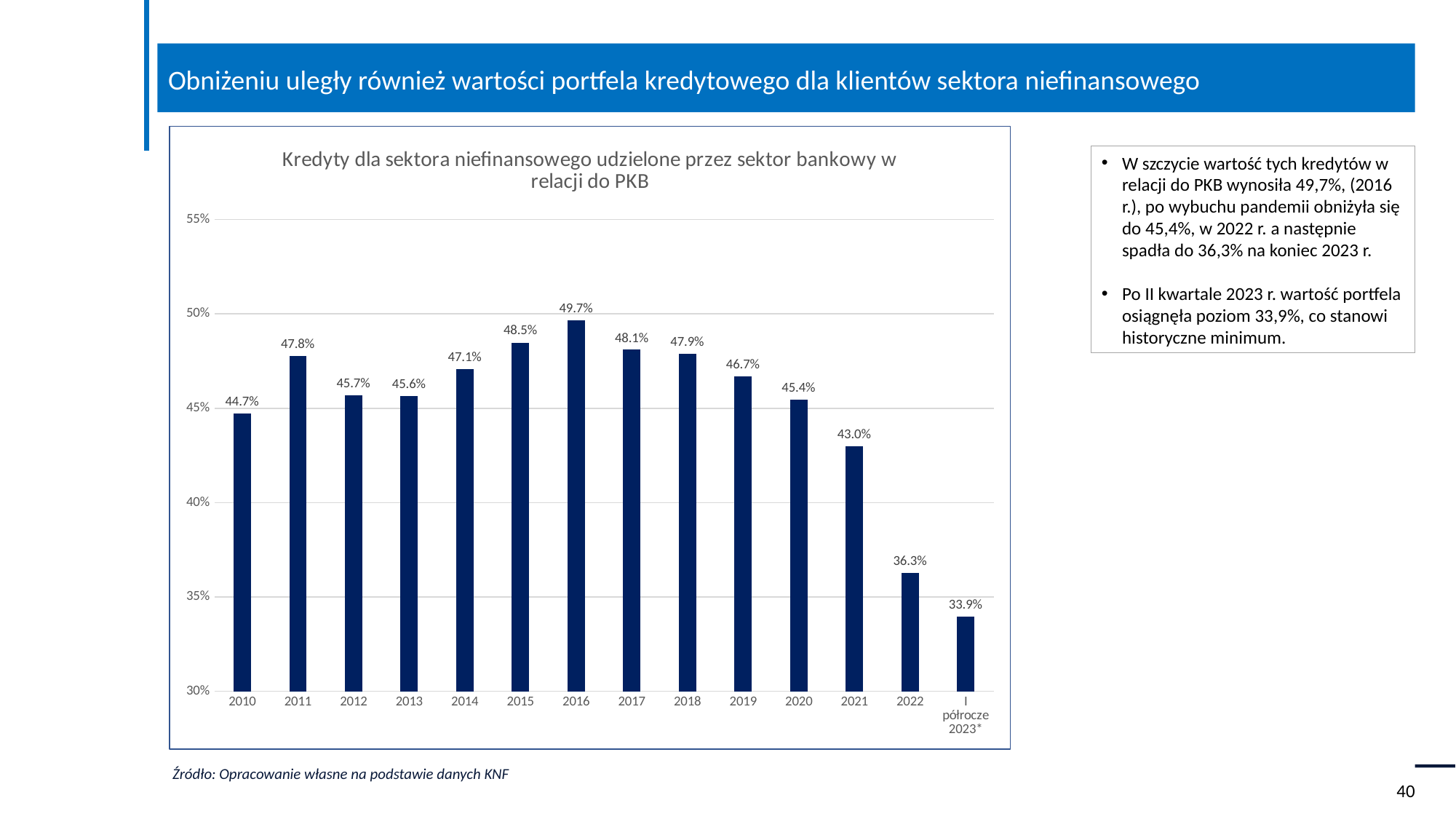
What is the difference between the values for 2021 and 2022? 6.7 percentage points Is the value for 2020 greater or less than 45%? greater What is the value for 2010? 44.7% How many categories are shown on the x axis? 14 What is the value for I półrocze 2023*? 33.9% Which category has the lowest value? I półrocze 2023* What is the value for 2016? 49.7% What is the title of the chart? Kredyty dla sektora niefinansowego udzielone przez sektor bankowy w relacji do PKB Which category has the highest value? 2016 What kind of chart is this? bar chart Do the values rise or fall from 2016 to I półrocze 2023*? fall Which is larger, the value for 2011 or the value for 2017? 2017